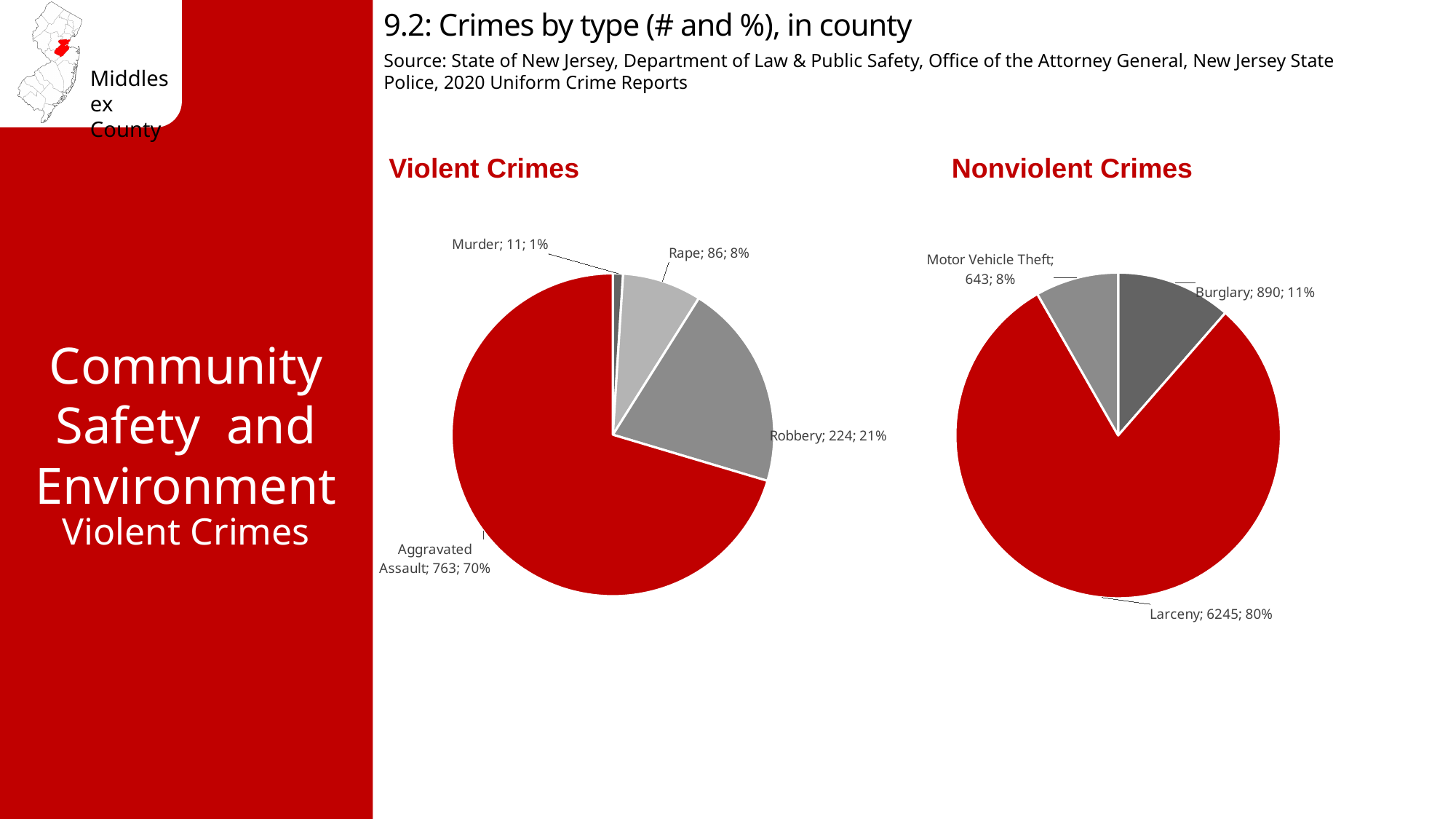
In the Nonviolent Crimes chart, how many Larceny crimes are shown? 6245 In the Violent Crimes chart, which category has the smallest slice? Murder In the Violent Crimes chart, what percentage share does Robbery have? 21% In the Nonviolent Crimes chart, which category has the largest slice? Larceny In the Nonviolent Crimes chart, what percentage share does Motor Vehicle Theft have? 8% What kind of chart is the Violent Crimes chart? Pie chart In the Violent Crimes chart, how many Aggravated Assault crimes are shown? 763 In the Nonviolent Crimes chart, which is larger, Burglary or Motor Vehicle Theft? Burglary In the Violent Crimes chart, what is the difference between the number of Robbery and Rape crimes? 138 In the Nonviolent Crimes chart, how many categories are shown? 3 In the Violent Crimes chart, how many categories are shown? 4 In the Nonviolent Crimes chart, what is the difference between the number of Burglary and Motor Vehicle Theft crimes? 247